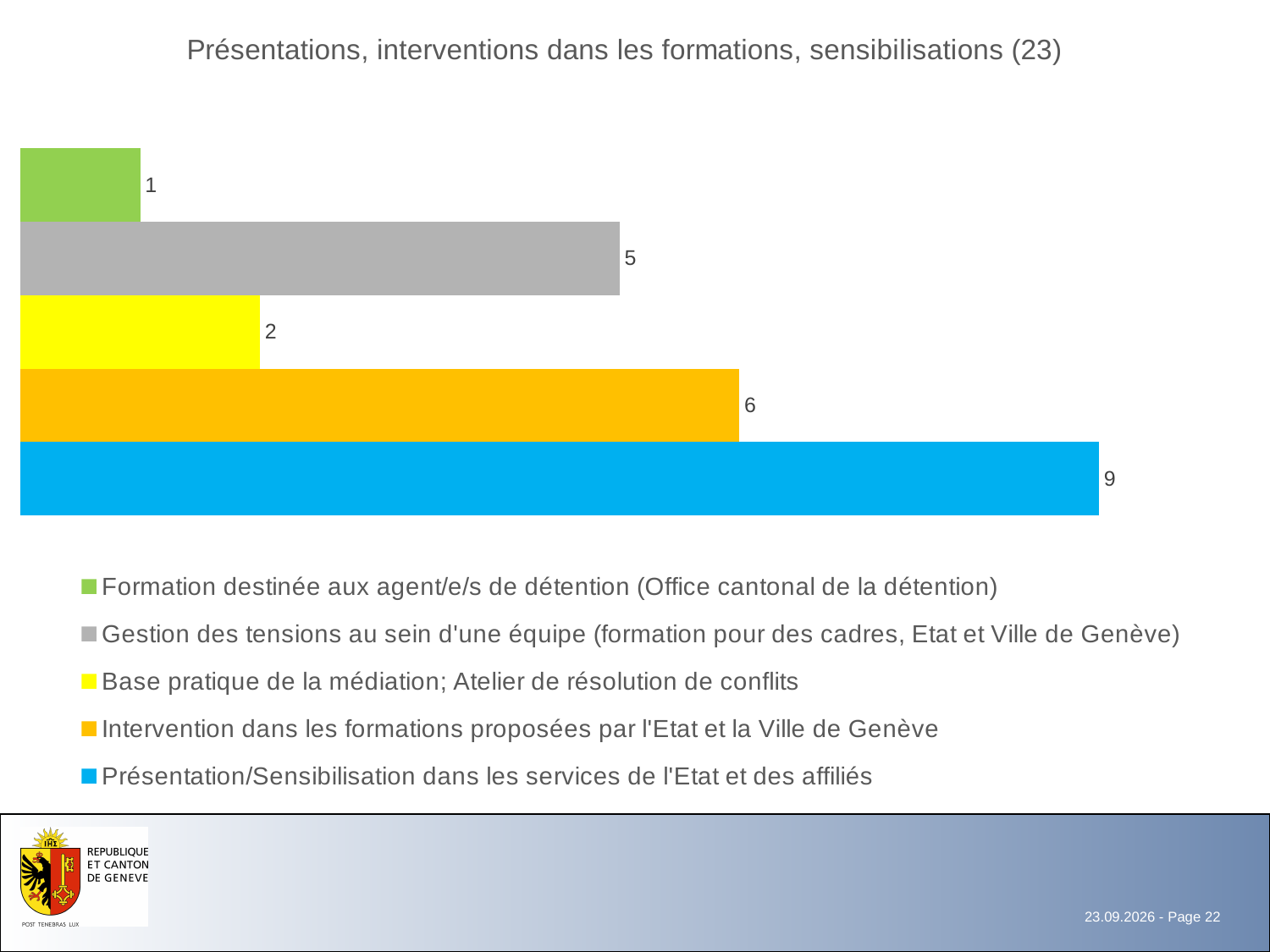
What is the value for "Base pratique de la médiation; Atelier de résolution de conflits"? 2 What is the value for "Formation destinée aux agent/e/s de détention (Office cantonal de la détention)"? 1 Which category has the lowest value? Formation destinée aux agent/e/s de détention (Office cantonal de la détention) What is the value for "Intervention dans les formations proposées par l'Etat et la Ville de Genève"? 6 What is the difference between the values for "Présentation/Sensibilisation dans les services de l'Etat et des affiliés" and "Intervention dans les formations proposées par l'Etat et la Ville de Genève"? 3 What is the title of the chart? Présentations, interventions dans les formations, sensibilisations (23) What is the value for "Présentation/Sensibilisation dans les services de l'Etat et des affiliés"? 9 Which category has the highest value? Présentation/Sensibilisation dans les services de l'Etat et des affiliés What kind of chart is shown on the slide? Bar chart Which is larger: the value for "Gestion des tensions au sein d'une équipe" or the value for "Base pratique de la médiation; Atelier de résolution de conflits"? Gestion des tensions au sein d'une équipe What is the value for "Gestion des tensions au sein d'une équipe (formation pour des cadres, Etat et Ville de Genève)"? 5 How many categories are shown in the chart? 5